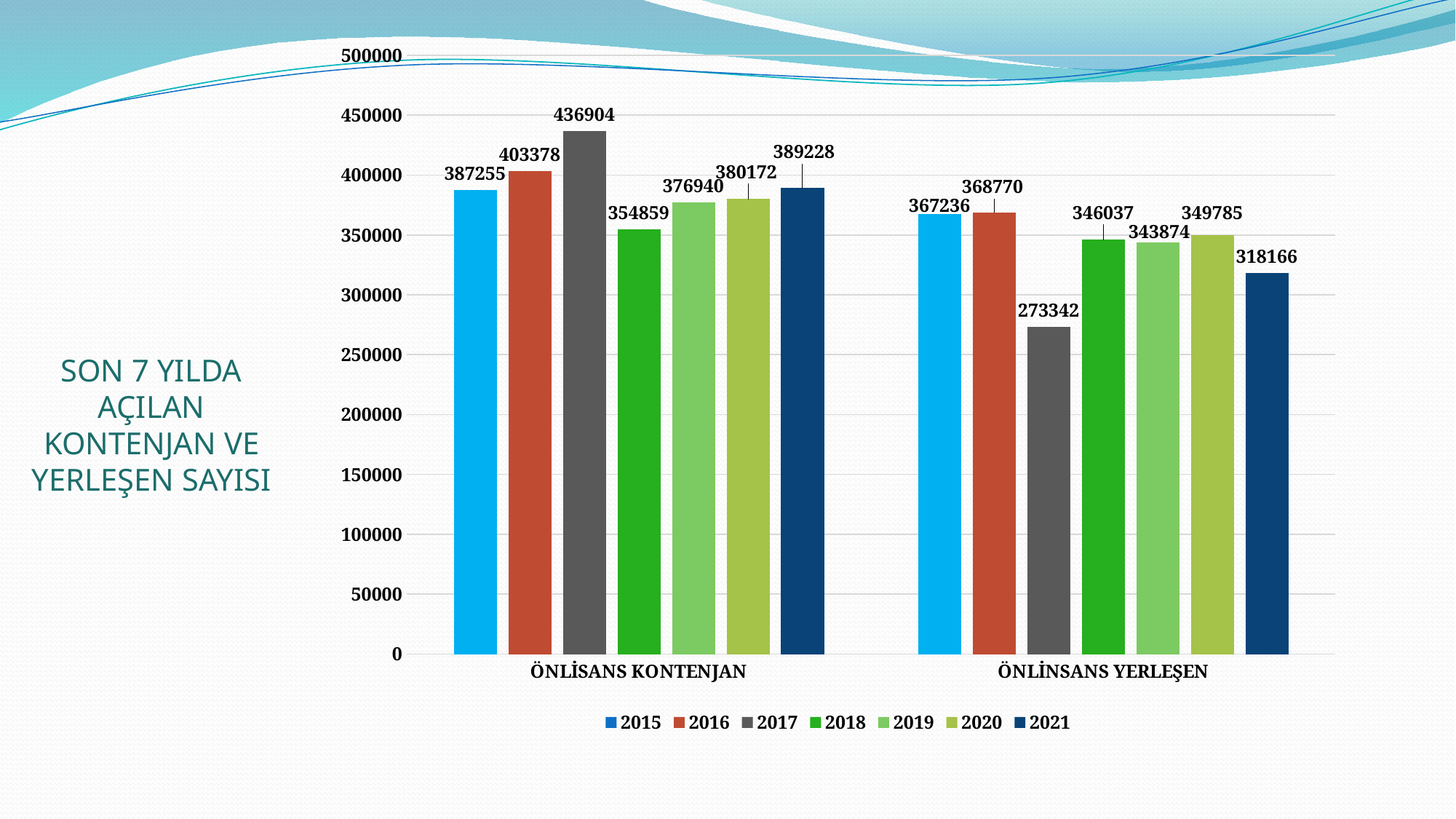
Which year has the lowest value in the ÖNLİNSANS YERLEŞEN category? 2017 Which year has the highest value in the ÖNLİSANS KONTENJAN category? 2017 Which is larger: the 2020 value for ÖNLİSANS KONTENJAN or the 2020 value for ÖNLİNSANS YERLEŞEN? ÖNLİSANS KONTENJAN How many series does the legend list? 7 What is the value for 2021 in the ÖNLİNSANS YERLEŞEN category? 318166 What is the value for 2017 in the ÖNLİSANS KONTENJAN category? 436904 What kind of chart is shown on the slide? Bar chart What is the difference between the 2017 and 2018 values in the ÖNLİSANS KONTENJAN category? 82045 What is the value for 2019 in the ÖNLİSANS KONTENJAN category? 376940 How many categories are shown on the x axis? 2 Which year has the lowest value in the ÖNLİSANS KONTENJAN category? 2018 What is the difference between the 2015 values for ÖNLİSANS KONTENJAN and ÖNLİNSANS YERLEŞEN? 20019